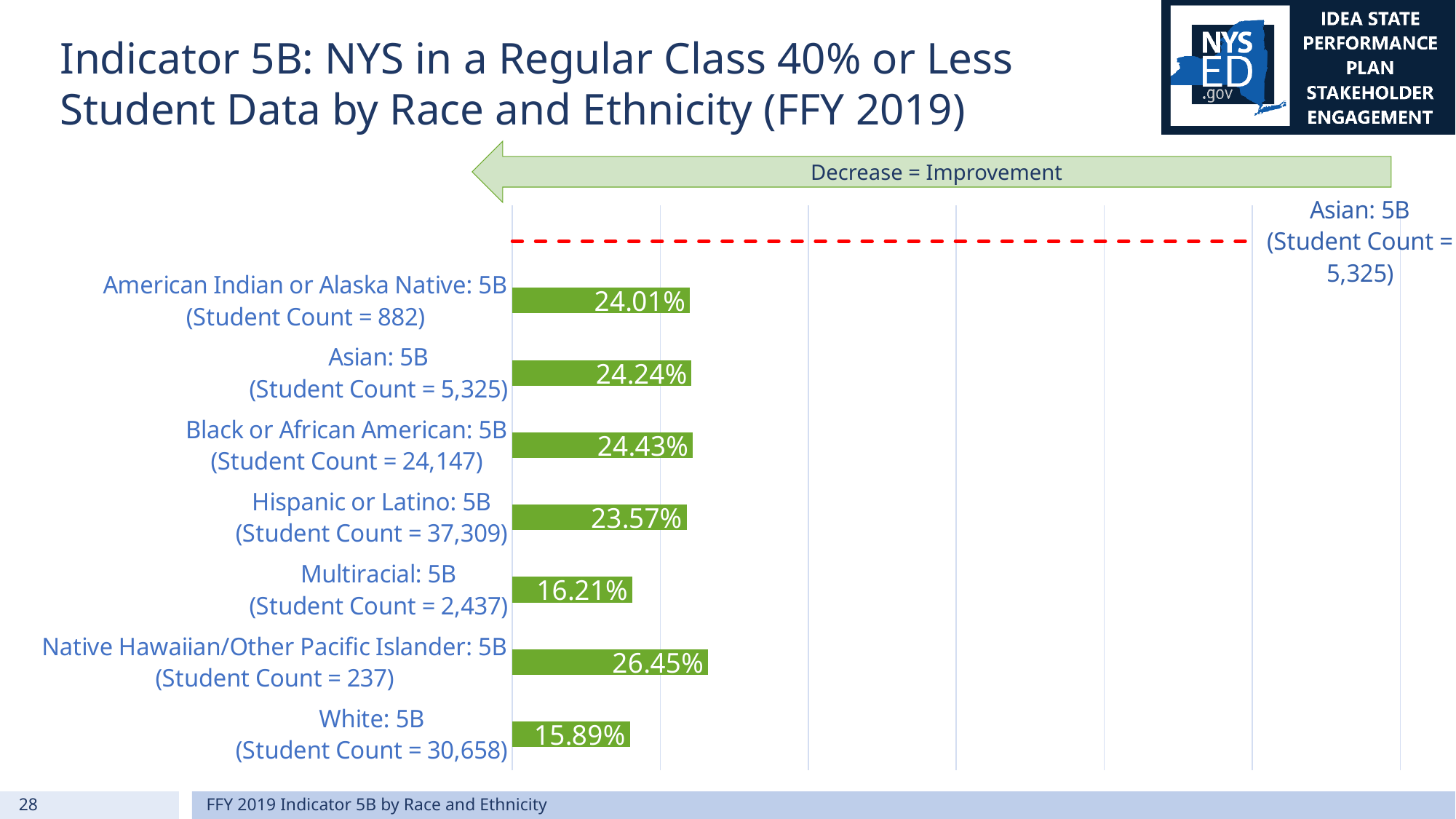
Which category has the highest value? Native Hawaiian/Other Pacific Islander: 5B What is the difference between the values for Black or African American: 5B and Hispanic or Latino: 5B? 0.86 percentage points What is the value for Hispanic or Latino: 5B? 23.57% What does the green arrow above the chart say? Decrease = Improvement What kind of chart is shown on the slide? Bar chart What is the difference between the values for Native Hawaiian/Other Pacific Islander: 5B and White: 5B? 10.56 percentage points What is the value for Multiracial: 5B? 16.21% How many categories are shown in the chart? 7 Which is larger, the value for Hispanic or Latino: 5B or the value for Multiracial: 5B? Hispanic or Latino: 5B Which category has the lowest value? White: 5B What is the value for Native Hawaiian/Other Pacific Islander: 5B? 26.45% What is the value for White: 5B? 15.89%